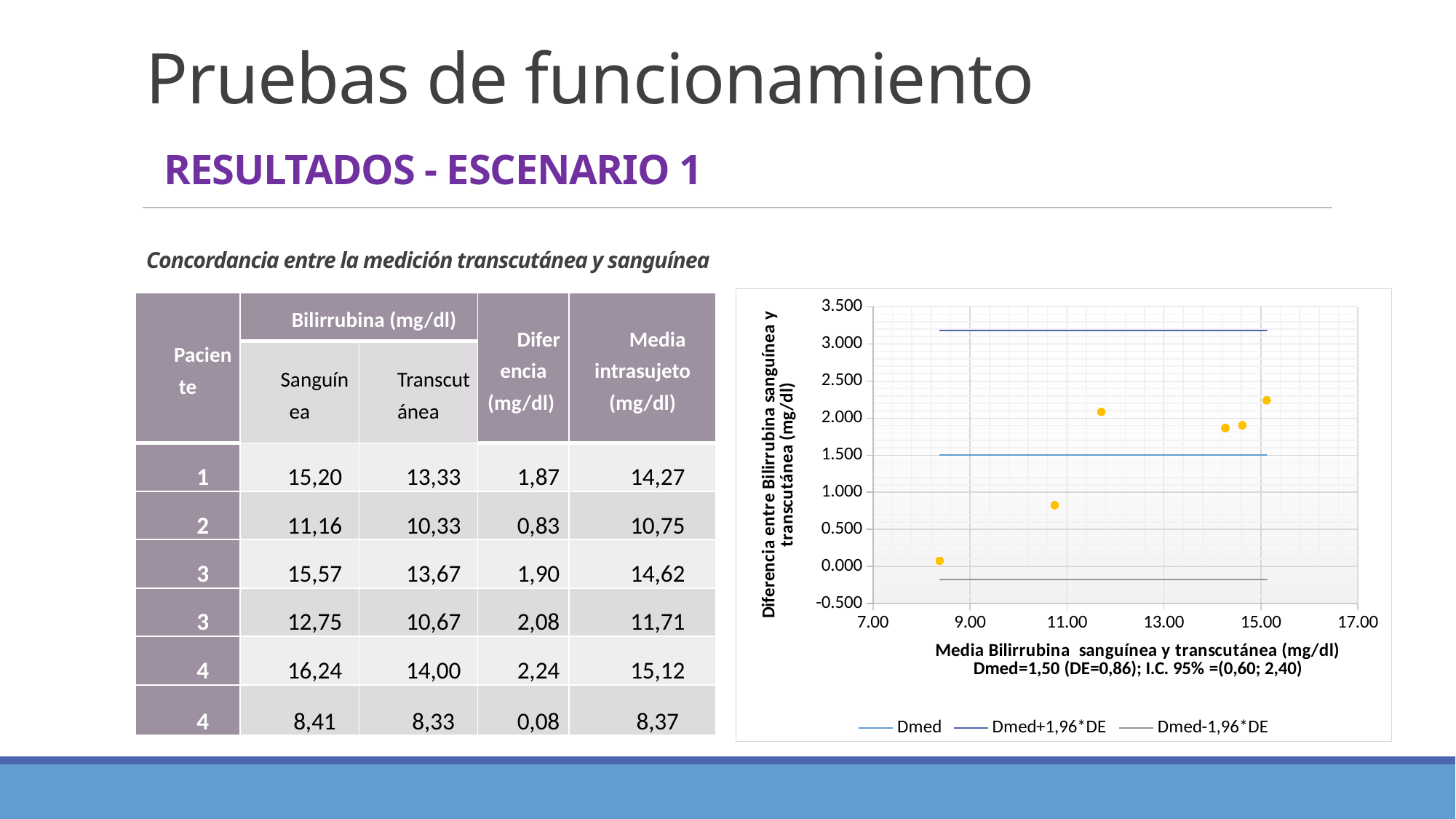
How many data points are plotted in the scatter chart? 6 Do the plotted differences generally rise or fall as the mean bilirubin increases along the x axis? rise What kind of chart is shown on the right of the slide? scatter chart Is the difference value for the rightmost point (near 15 mg/dl on the x axis) greater or less than 2.000? greater What 95% confidence interval is stated below the x axis of the chart? (0,60; 2,40) What is the label of the x axis of the scatter chart? Media Bilirrubina sanguínea y transcutánea (mg/dl) How many series does the legend of the scatter chart list? 3 Is the difference value for the point near 10.8 mg/dl on the x axis greater or less than 1.000? less What is the DE value stated below the x axis of the chart? 0,86 Is the difference value for the leftmost point (near 8.4 mg/dl on the x axis) greater or less than 0.500? less What are the three legend entries of the scatter chart? Dmed, Dmed+1,96*DE, Dmed-1,96*DE What is the value of Dmed stated below the x axis of the chart? 1,50